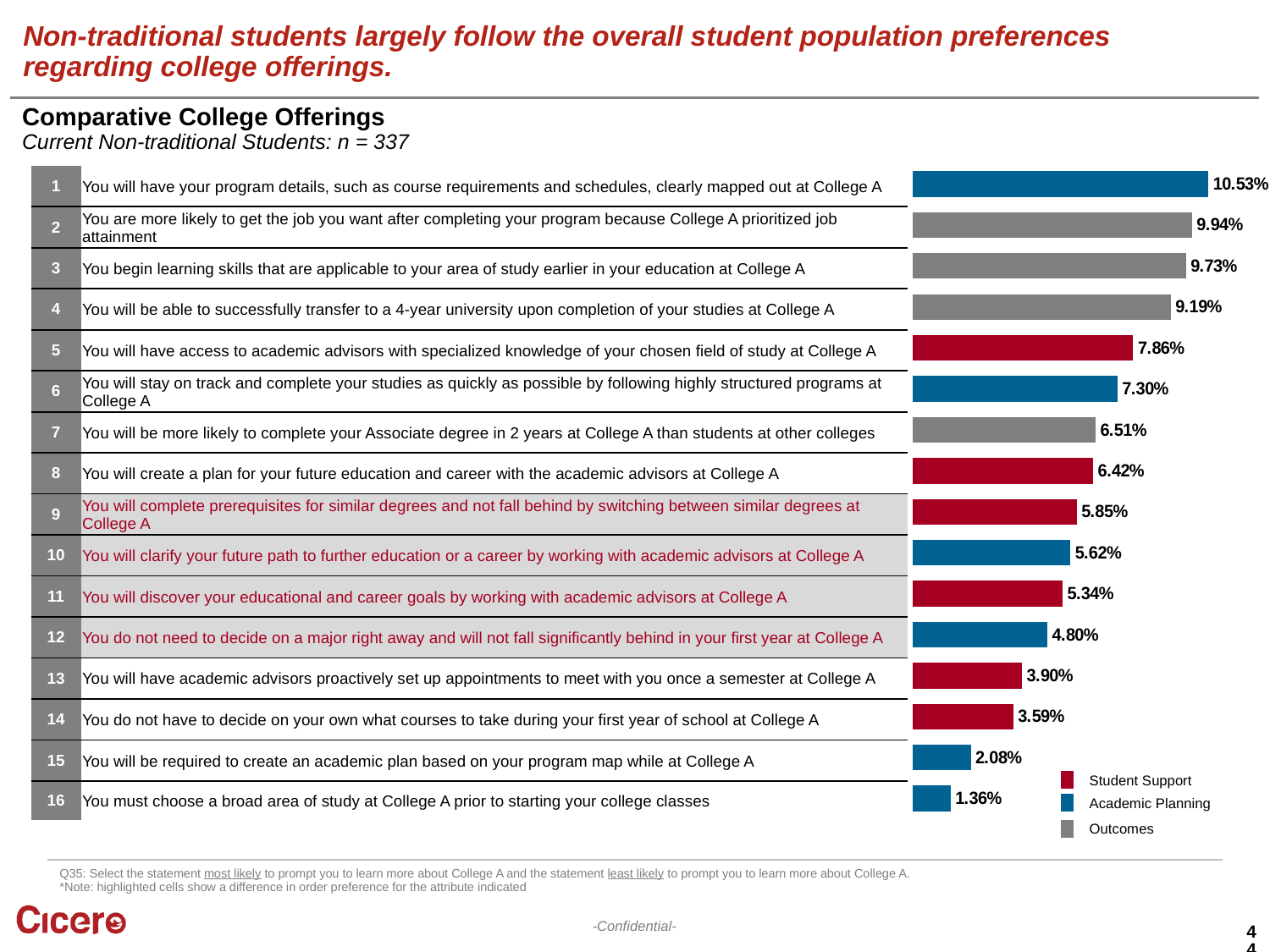
How many statements are plotted in the chart? 16 What is the difference between the values for statement 1 (10.53%) and statement 2 (9.94%)? 0.59% What type of chart is shown on the slide? Bar chart How many categories does the chart legend list? 3 Which statement number has the highest value in the chart? 1 According to the legend, which category is shown in gray? Outcomes What is the value for statement 1, "You will have your program details, such as course requirements and schedules, clearly mapped out at College A"? 10.53% What is the difference between the values for statement 15 (2.08%) and statement 16 (1.36%)? 0.72% What is the value for statement 16, "You must choose a broad area of study at College A prior to starting your college classes"? 1.36% Which has a larger value: statement 7 ("You will be more likely to complete your Associate degree in 2 years at College A than students at other colleges") or statement 13 ("You will have academic advisors proactively set up appointments to meet with you once a semester at College A")? Statement 7 What is the value for statement 5, "You will have access to academic advisors with specialized knowledge of your chosen field of study at College A"? 7.86% Which statement number has the lowest value in the chart? 16